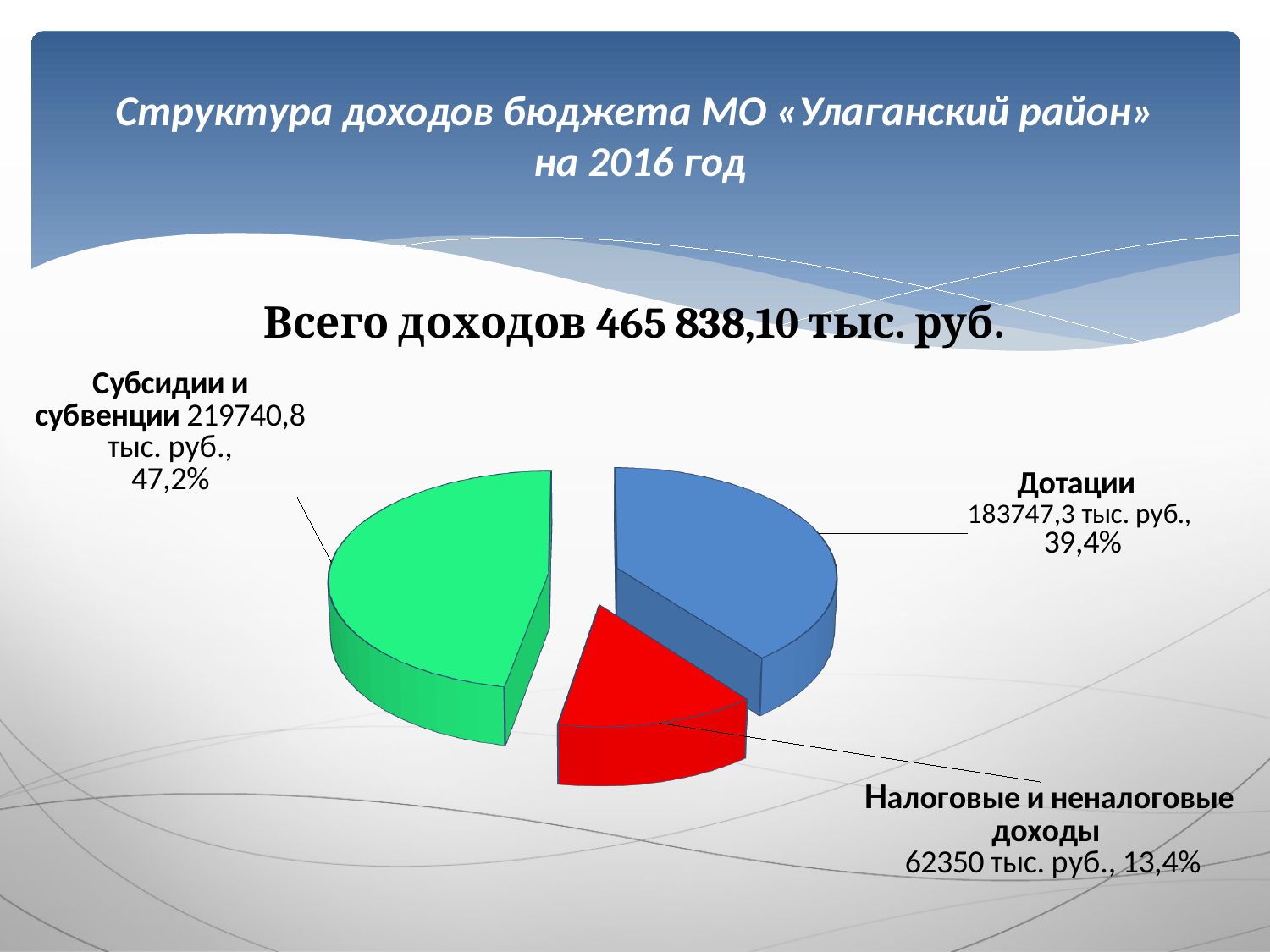
What total income is stated in the chart title? 465 838,10 тыс. руб. Which is larger, Дотации or Налоговые и неналоговые доходы? Дотации What colour is the slice for Дотации? Blue What is the value shown for Дотации? 183747,3 тыс. руб. What is the difference in percentage points between the share of Субсидии и субвенции and the share of Налоговые и неналоговые доходы? 33,8 Which slice of the pie chart is the largest? Субсидии и субвенции What share of the pie does Субсидии и субвенции represent? 47,2% How many slices does the pie chart have? 3 What is the value shown for Налоговые и неналоговые доходы? 62350 тыс. руб. Which slice of the pie chart is the smallest? Налоговые и неналоговые доходы What kind of chart is shown on the slide? Pie chart What share of the pie does Налоговые и неналоговые доходы represent? 13,4%